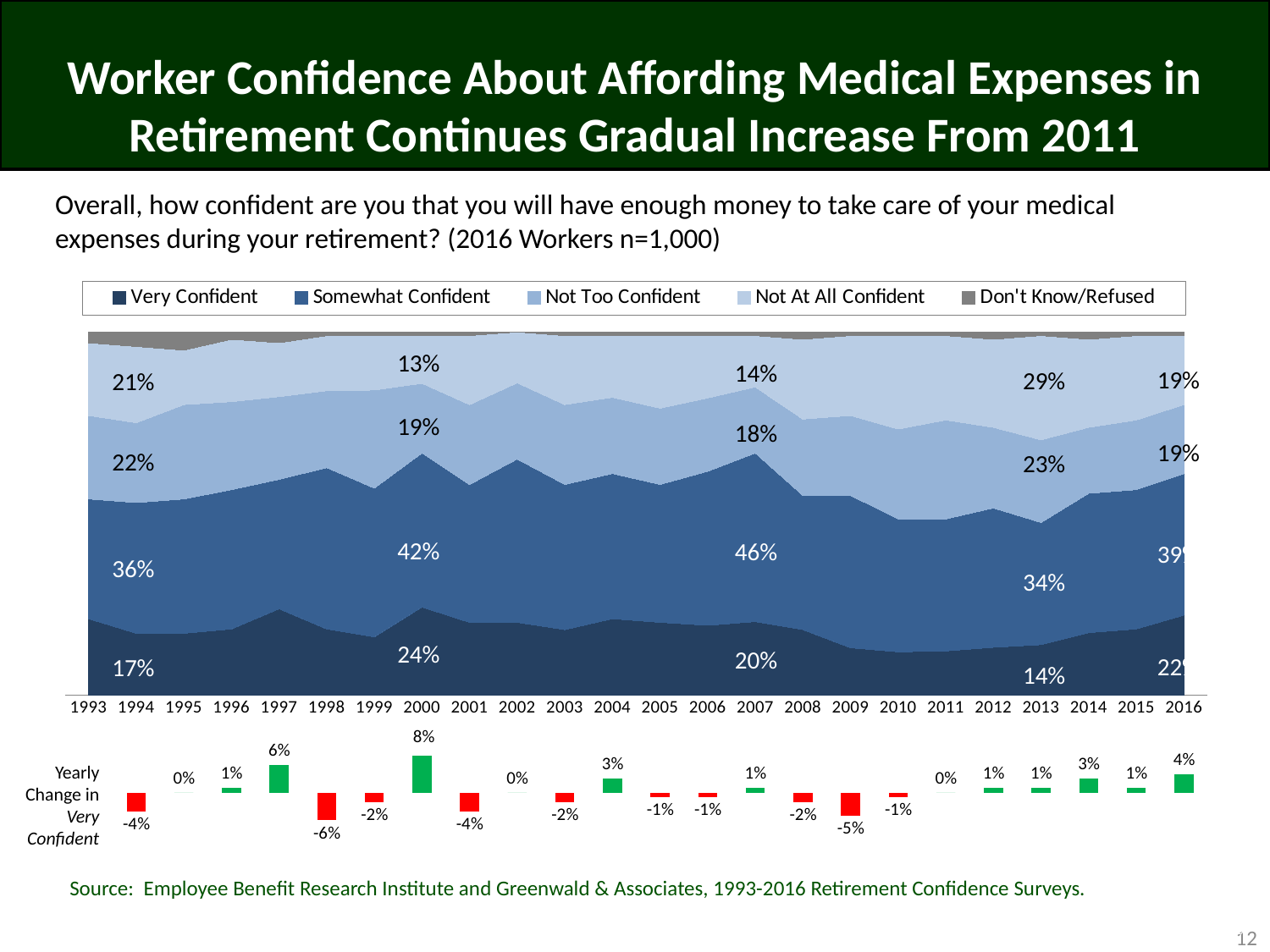
In the stacked area chart, what percentage of workers were Somewhat Confident in 2007? 46% In the stacked area chart, what percentage of workers were Very Confident in 2000? 24% In the Yearly Change in Very Confident bar chart, what is the value for 2009? -5% How many series does the legend of the stacked area chart list? 5 In the Yearly Change in Very Confident bar chart, which year has the largest decrease? 1998 In the Yearly Change in Very Confident bar chart, what is the value for 2016? 4% In the stacked area chart, was the Somewhat Confident share larger in 2007 or in 2013? 2007 In the stacked area chart, what percentage of workers were Not At All Confident in 2013? 29% What kind of chart is the main chart showing confidence levels from 1993 to 2016? Stacked area chart In the Yearly Change in Very Confident bar chart, which year has the largest increase? 2000